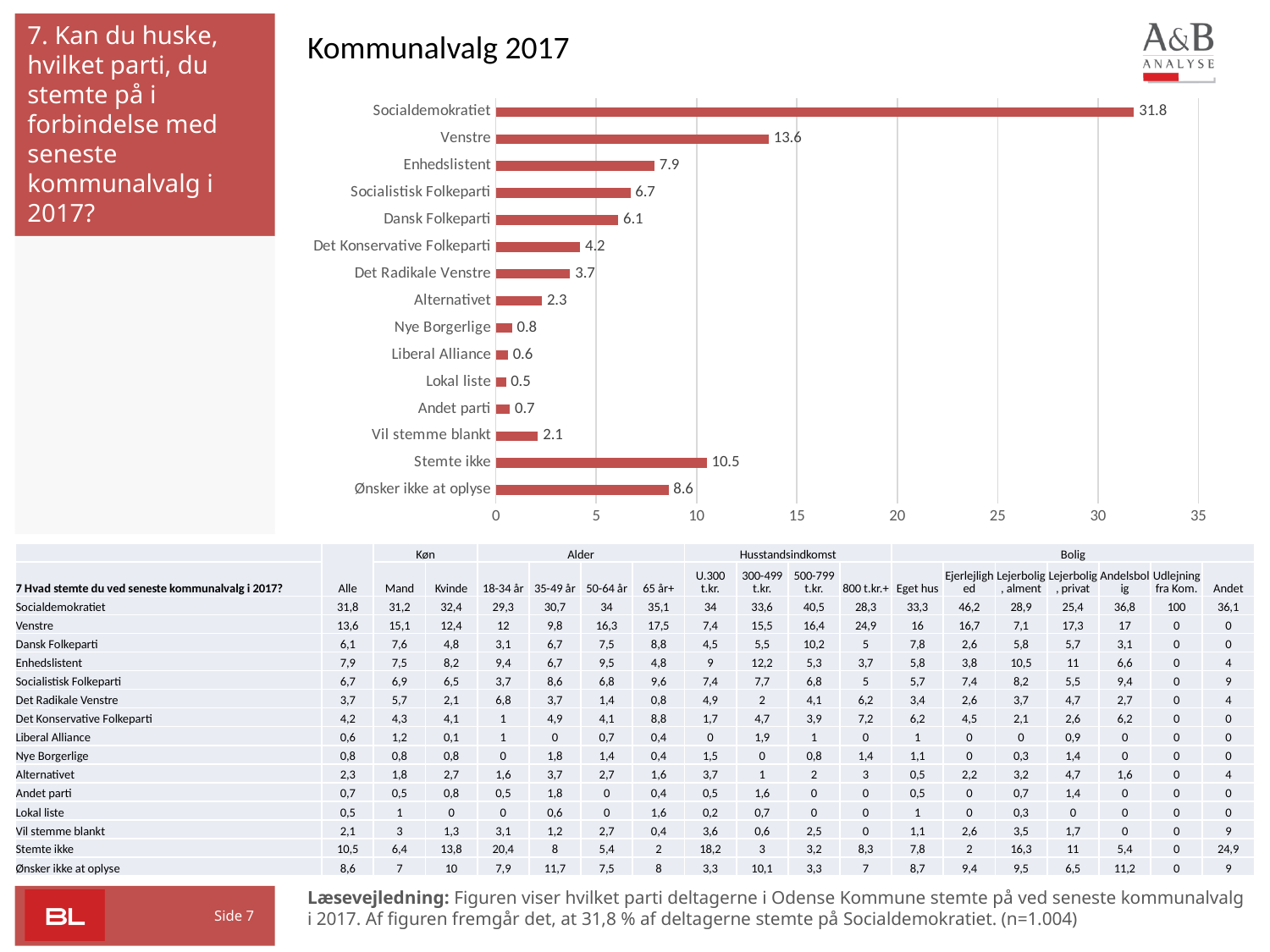
How many categories are shown in the Kommunalvalg 2017 chart? 15 What value is shown for Socialdemokratiet in the Kommunalvalg 2017 chart? 31.8 What is the difference between the values for Stemte ikke and Ønsker ikke at oplyse in the Kommunalvalg 2017 chart? 1.9 What is the difference between the values for Socialdemokratiet and Venstre in the Kommunalvalg 2017 chart? 18.2 What value is shown for Stemte ikke in the Kommunalvalg 2017 chart? 10.5 What type of chart is the Kommunalvalg 2017 chart? bar chart What value is shown for Venstre in the Kommunalvalg 2017 chart? 13.6 Is the value for Venstre in the Kommunalvalg 2017 chart greater or less than 15? less Which has a larger value in the Kommunalvalg 2017 chart, Enhedslistent or Dansk Folkeparti? Enhedslistent What value is shown for Det Radikale Venstre in the Kommunalvalg 2017 chart? 3.7 Which category has the lowest value in the Kommunalvalg 2017 chart? Lokal liste Which category has the highest value in the Kommunalvalg 2017 chart? Socialdemokratiet